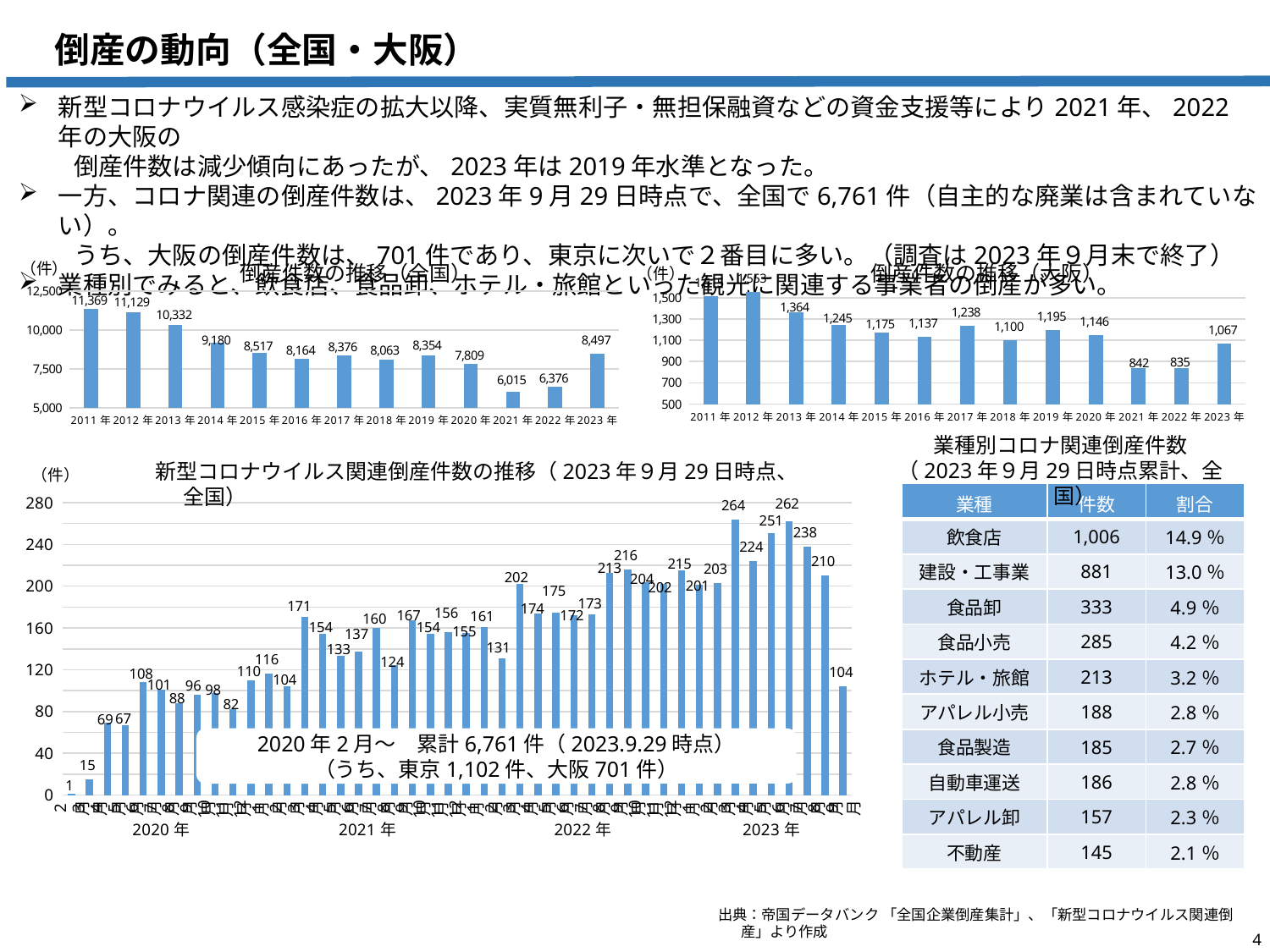
In the top-right chart (Osaka bankruptcies), what is the difference between the values for 2023年 and 2022年? 232 In the top-left chart (nationwide bankruptcies), is the value for 2020年 greater or less than 7,500? greater In the top-right chart (Osaka bankruptcies), what is the value for 2018年? 1,100 In the bottom chart (COVID-related bankruptcies), what is the highest monthly value labeled? 264 In the top-left chart (nationwide bankruptcies), which year has the highest value? 2011年 In the bottom chart (COVID-related bankruptcies), what is the lowest monthly value labeled? 1 What type of chart is the bottom chart (COVID-related bankruptcies)? bar chart In the top-left chart (nationwide bankruptcies), which year has the lowest value? 2021年 In the top-left chart (nationwide bankruptcies), what is the value for 2023年? 8,497 In the top-left chart (nationwide bankruptcies), how many years are plotted? 13 In the top-left chart (nationwide bankruptcies), what is the difference between the values for 2023年 and 2022年? 2,121 In the top-right chart (Osaka bankruptcies), what is the value for 2013年? 1,364